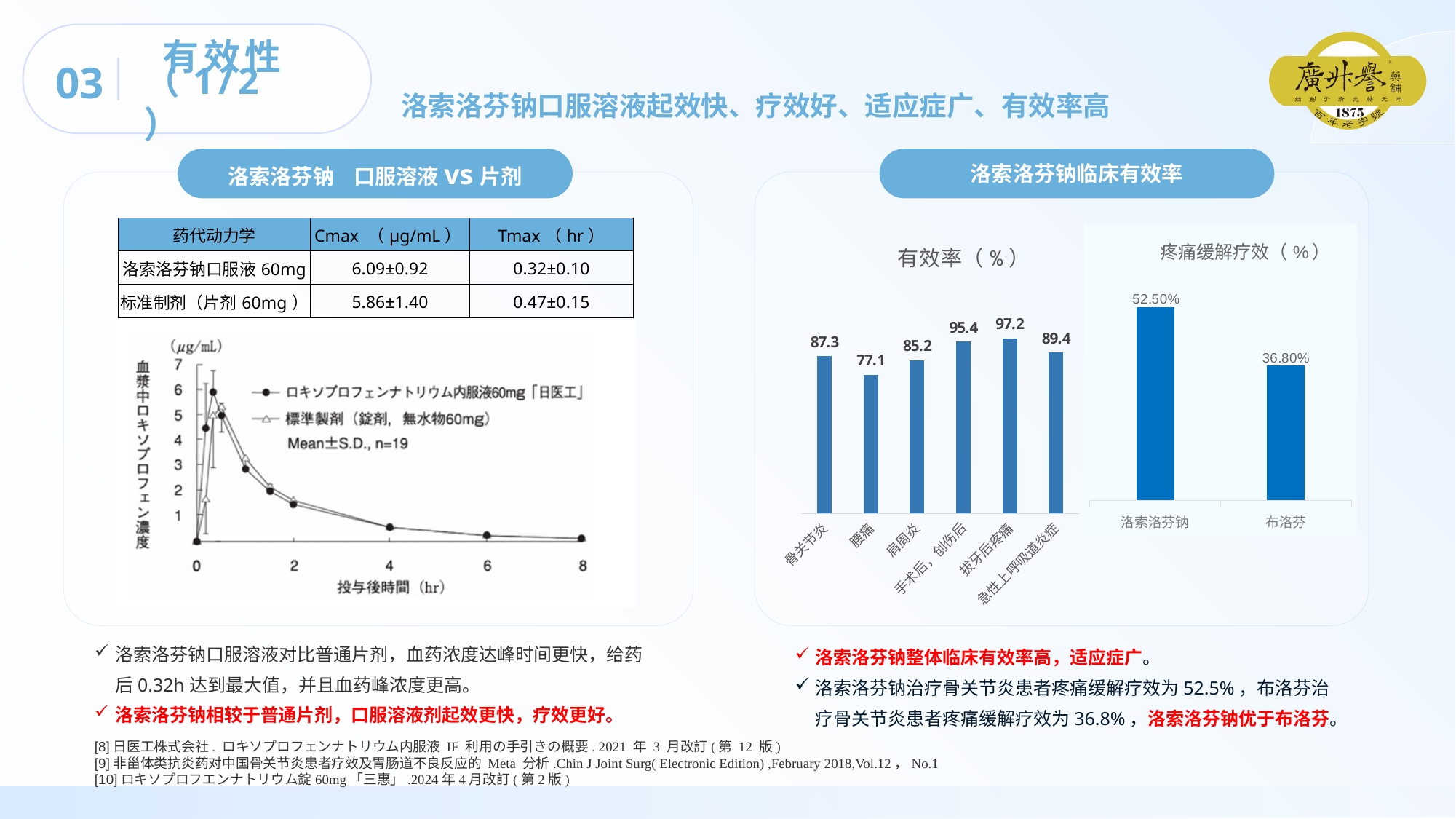
In the 有效率（%） chart, what is the difference between 手术后、创伤后 and 肩周炎? 10.2 In the 疼痛缓解疗效（%） chart, what is the value for 布洛芬? 36.80% In the 疼痛缓解疗效（%） chart, what is the value for 洛索洛芬钠? 52.50% How many categories are shown in the 有效率（%） chart? 6 In the 有效率（%） chart, which is larger: 急性上呼吸道炎症 or 骨关节炎? 急性上呼吸道炎症 What kind of chart is the chart at the bottom left of the slide showing plasma concentration over time? Line chart In the 有效率（%） chart, what is the value for 骨关节炎? 87.3 In the 有效率（%） chart, which category has the highest value? 拔牙后疼痛 In the 疼痛缓解疗效（%） chart, what is the difference between 洛索洛芬钠 and 布洛芬? 15.70% In the 有效率（%） chart, which category has the lowest value? 腰痛 In the 有效率（%） chart, what is the value for 拔牙后疼痛? 97.2 What kind of chart is the 有效率（%） chart? Bar chart